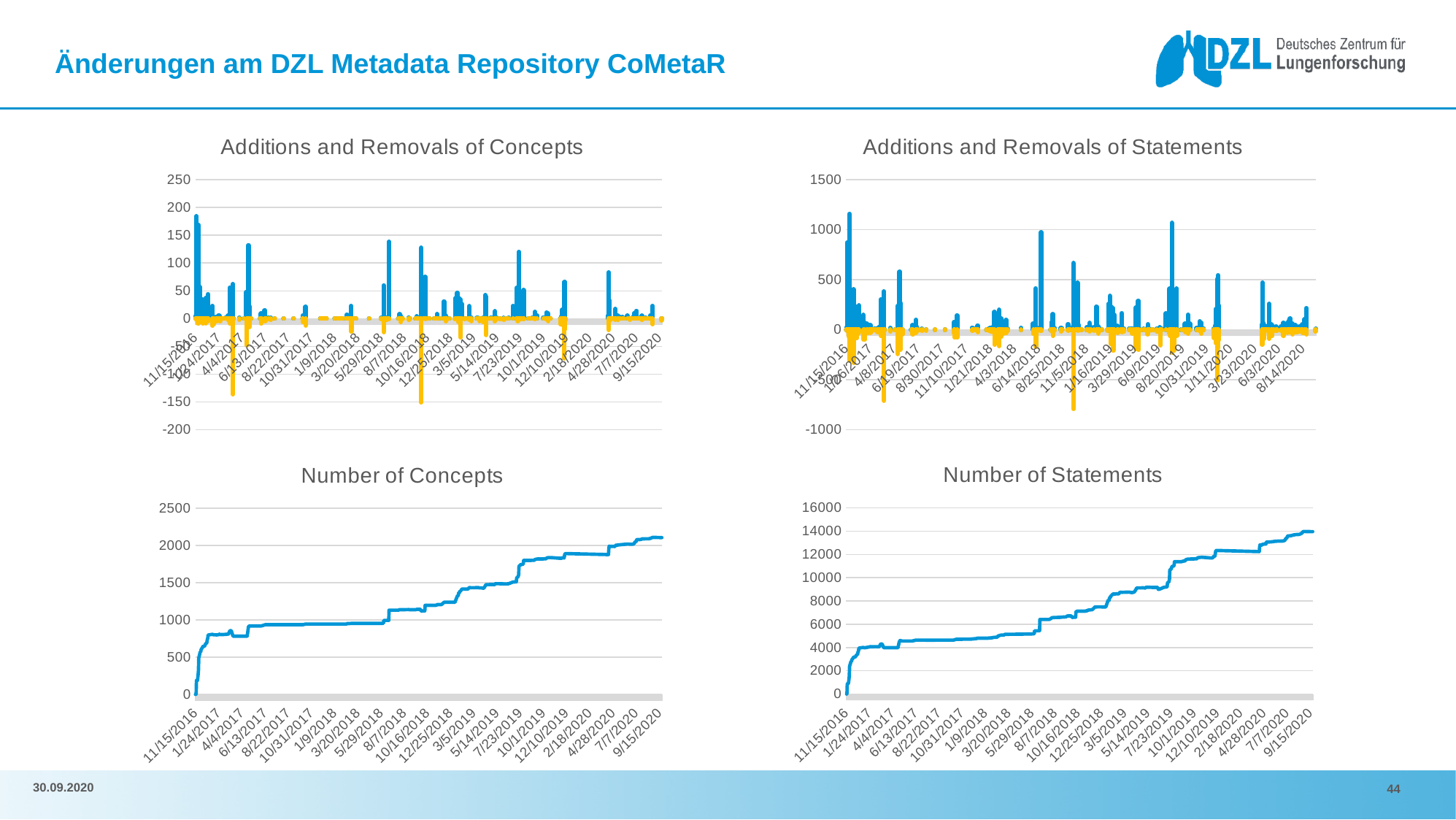
In the 'Number of Concepts' chart, do the values rise or fall from 11/15/2016 to 9/15/2020? rise What kind of chart is the 'Additions and Removals of Statements' chart? bar chart In the 'Number of Concepts' chart, is the value at 1/24/2017 greater or less than 1000? less In the 'Number of Statements' chart, is the value at 12/10/2019 greater or less than 10000? greater In the 'Additions and Removals of Statements' chart, is the tallest blue bar greater or less than 1000? greater In the 'Number of Statements' chart, do the values rise or fall along the x axis? rise What is the title of the top-left chart on the slide? Additions and Removals of Concepts What kind of chart is the 'Number of Concepts' chart? line chart